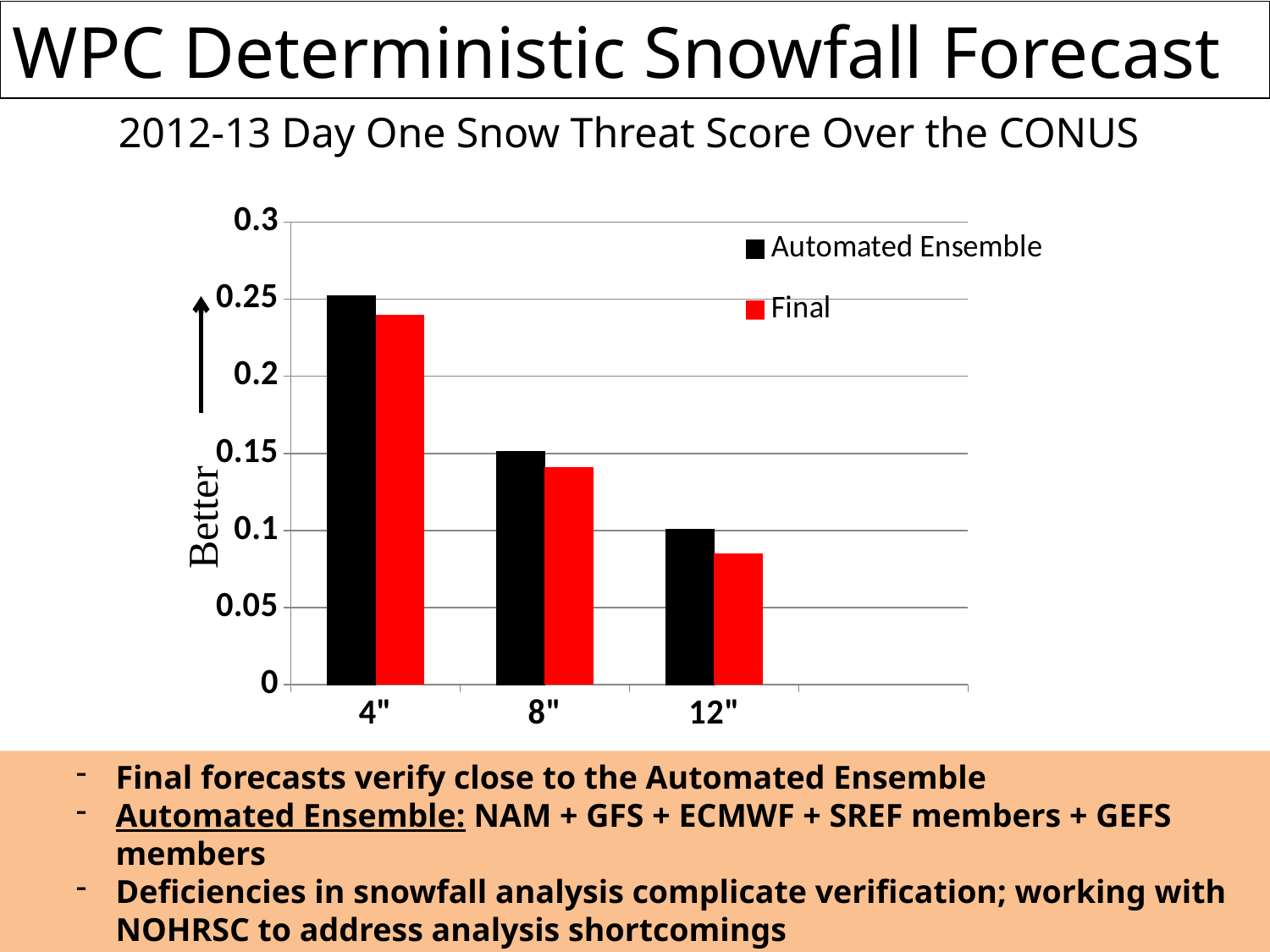
What kind of chart is shown on the slide? bar chart Which category has the lowest Final threat score? 12" Which category has the highest Automated Ensemble threat score? 4" Which colour represents the Final series in the chart? red For the 4" category, which series has the larger threat score, Automated Ensemble or Final? Automated Ensemble How many series does the chart legend list? 2 For the 12" category, which series has the larger threat score, Automated Ensemble or Final? Automated Ensemble Is the Final threat score for 12" greater or less than 0.1? less Is the Automated Ensemble threat score for 4" greater or less than 0.2? greater Do the threat scores rise or fall as the snowfall threshold increases from 4" to 12"? fall How many snowfall threshold categories are shown on the x axis? 3 Is the Final threat score for 4" greater or less than 0.25? less